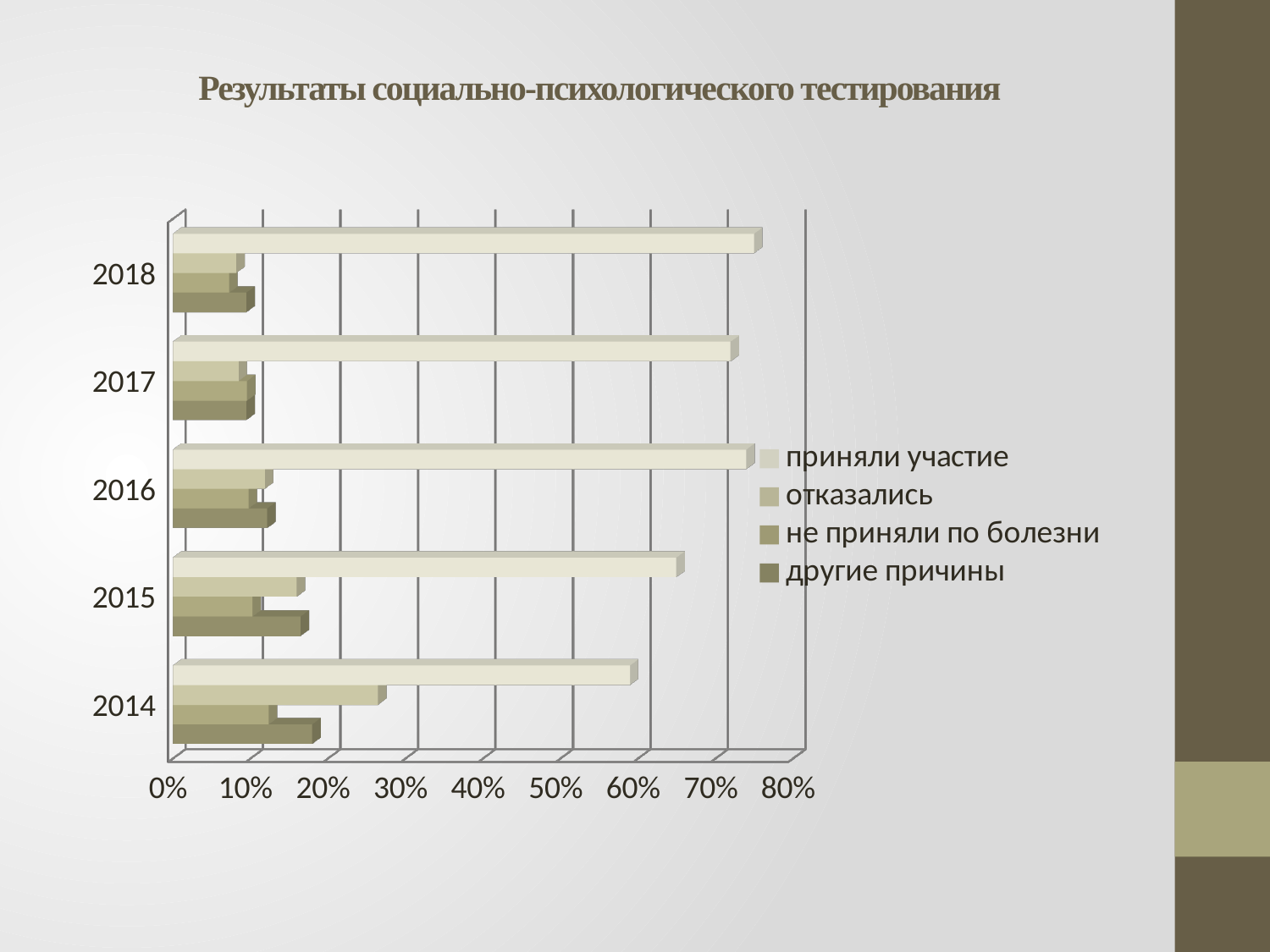
Is the value for 'приняли участие' in 2014 greater or less than 50%? greater How many years (categories) are shown on the chart? 5 Which series is listed first in the legend? приняли участие What is the title of the chart? Результаты социально-психологического тестирования Is the value for 'отказались' in 2014 greater or less than 20%? greater How many series does the legend list? 4 Which is larger: 'приняли участие' in 2015 or 'приняли участие' in 2014? 2015 Which year has the highest value for 'отказались'? 2014 Which year has the lowest value for 'приняли участие'? 2014 Is the value for 'отказались' in 2018 greater or less than 10%? less What kind of chart is shown on the slide? bar chart